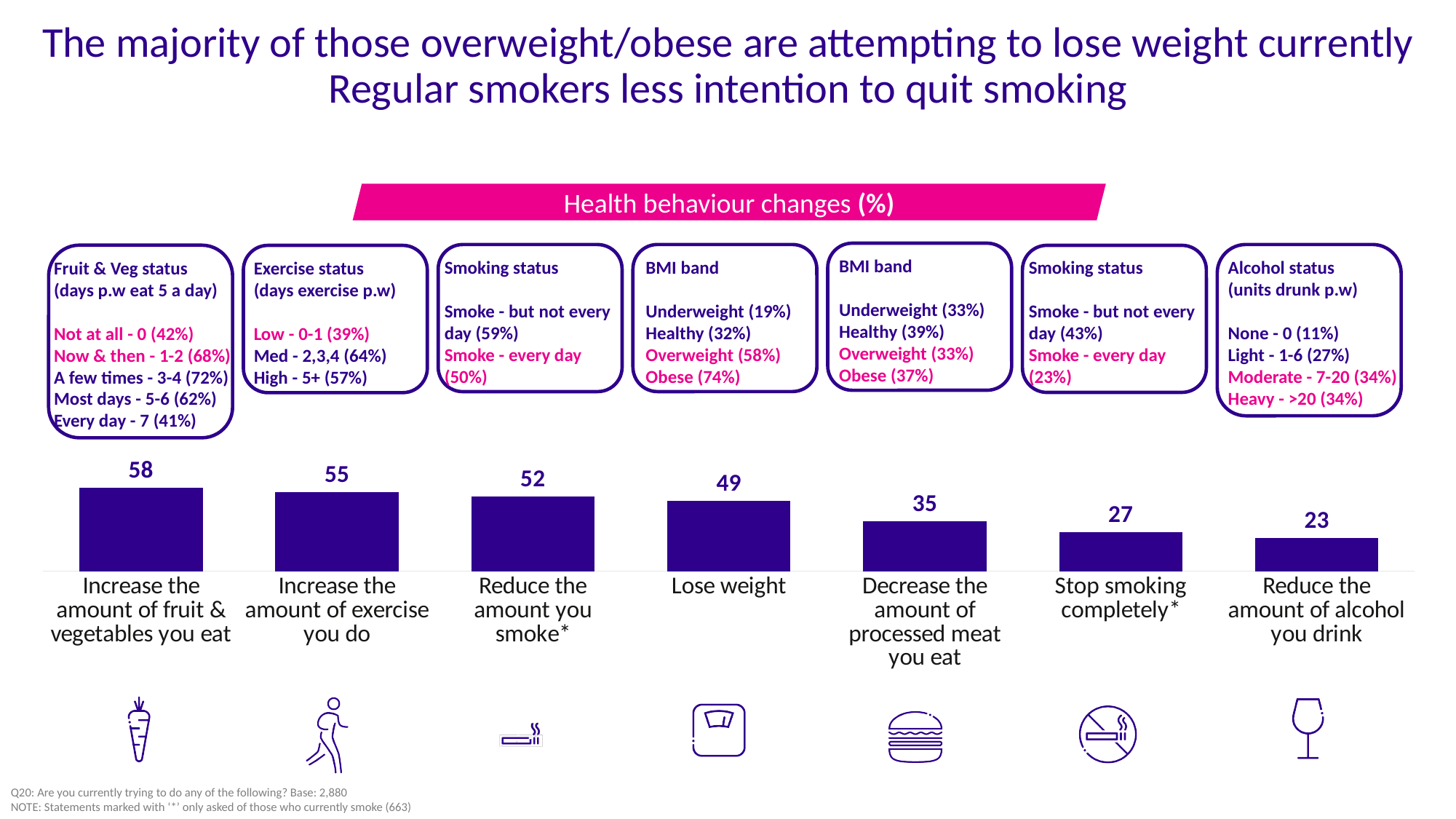
What is the value for 'Decrease the amount of processed meat you eat'? 35 What is the difference between 'Lose weight' and 'Decrease the amount of processed meat you eat'? 14 Do the values rise or fall from left to right across the categories? Fall How many categories are shown in the bar chart? 7 What is the value for 'Reduce the amount of alcohol you drink'? 23 What is the difference between 'Increase the amount of fruit & vegetables you eat' and 'Stop smoking completely'? 31 What kind of chart is shown on the slide? Bar chart Which category has the lowest value? Reduce the amount of alcohol you drink What is the value for 'Lose weight'? 49 Which category has the highest value? Increase the amount of fruit & vegetables you eat Which is larger: 'Increase the amount of exercise you do' or 'Reduce the amount you smoke'? Increase the amount of exercise you do What is the title shown in the pink banner above the chart? Health behaviour changes (%)